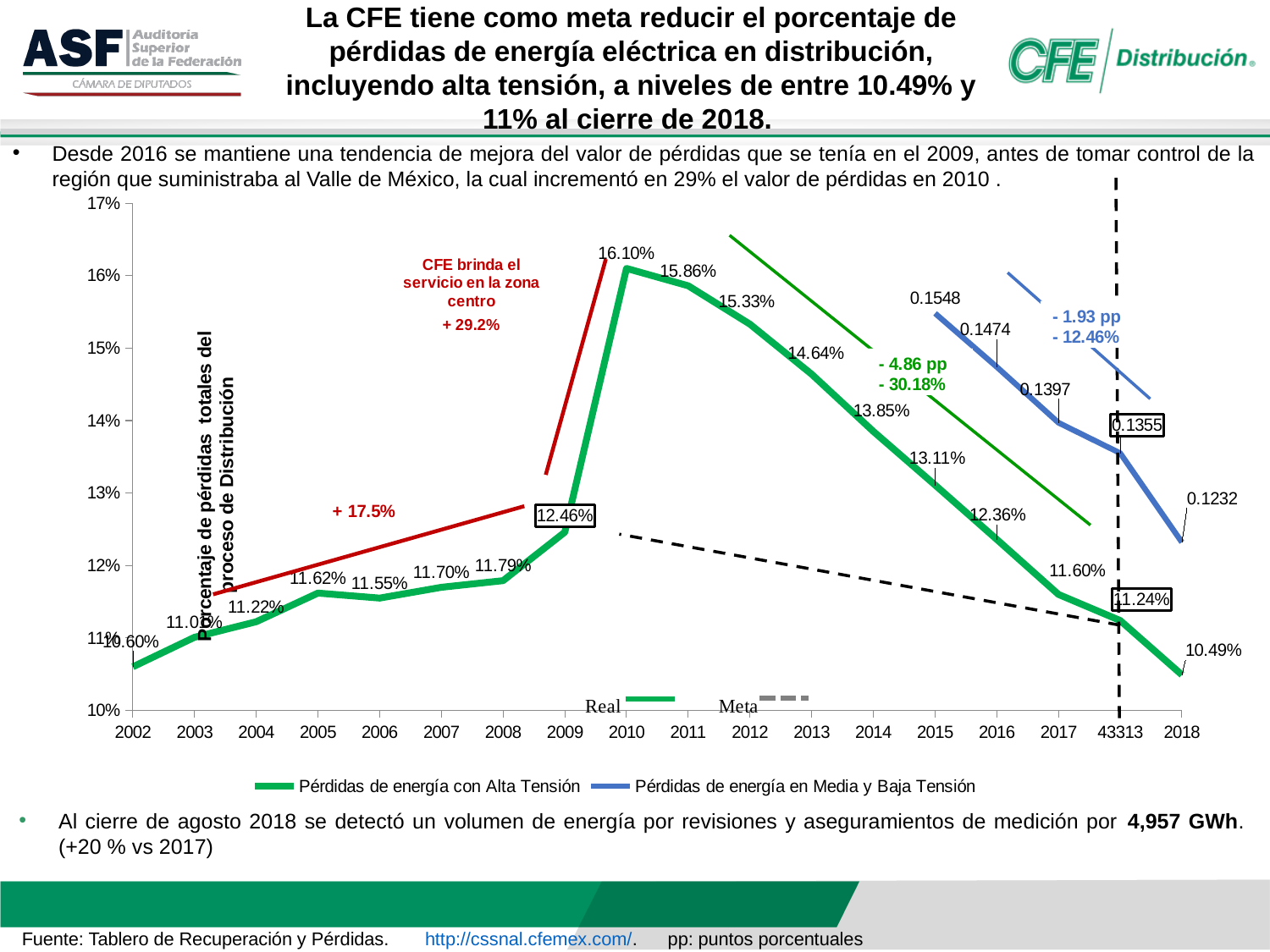
What is the difference between the Pérdidas de energía en Media y Baja Tensión values for 2015 (0.1548) and 2018 (0.1232)? 0.0316 What is the value of Pérdidas de energía con Alta Tensión for 2018? 10.49% What is the value of Pérdidas de energía con Alta Tensión for 2010? 16.10% What is the value of Pérdidas de energía con Alta Tensión for 2002? 10.60% In which year does the Pérdidas de energía con Alta Tensión series reach its highest value? 2010 Which year has the higher value for Pérdidas de energía con Alta Tensión, 2005 or 2006? 2005 By how many percentage points did Pérdidas de energía con Alta Tensión increase from 2009 (12.46%) to 2010 (16.10%)? 3.64 percentage points In which year does the Pérdidas de energía con Alta Tensión series reach its lowest value? 2018 What kind of chart is shown on the slide? Line chart Does the Pérdidas de energía con Alta Tensión series rise or fall from 2010 to 2018? Fall What is the value of Pérdidas de energía en Media y Baja Tensión for 2015? 0.1548 How many series does the chart legend list? 2